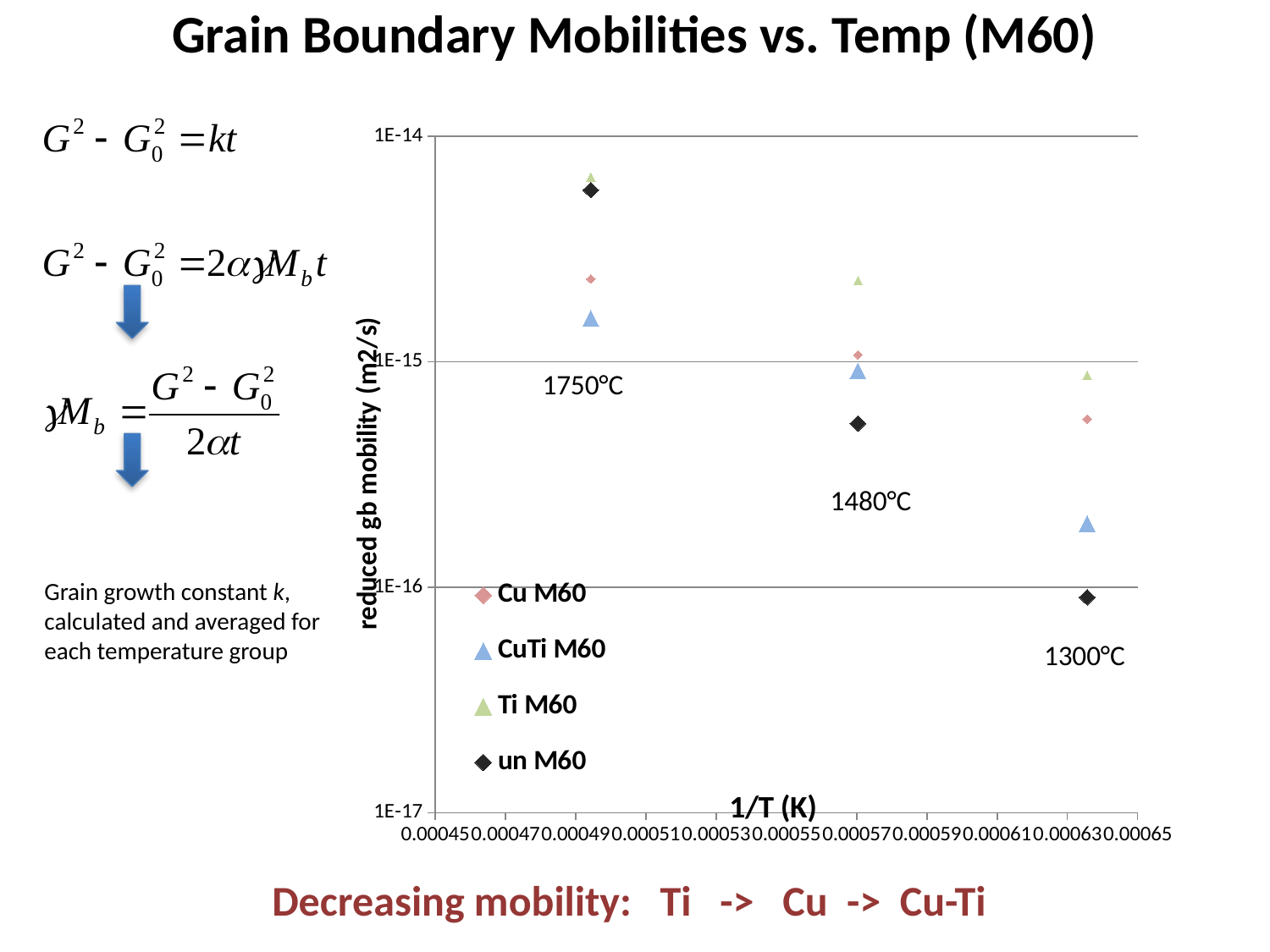
Which series has the highest mobility at 1480°C? Ti M60 Which series has the lowest mobility at 1750°C? CuTi M60 What is the label of the y axis? reduced gb mobility (m2/s) What kind of chart is shown on the slide? scatter chart Do the mobility values for un M60 rise or fall as 1/T increases along the x axis? fall Is the value for un M60 at 1480°C greater or less than 1E-15? less Which is larger at 1300°C, Ti M60 or CuTi M60? Ti M60 How many series does the chart legend list? 4 Which series has the lowest mobility at 1300°C? un M60 How many temperature groups are labelled on the chart? 3 What is the title of the chart? Grain Boundary Mobilities vs. Temp (M60) Is the value for CuTi M60 at 1300°C greater or less than 1E-16? greater